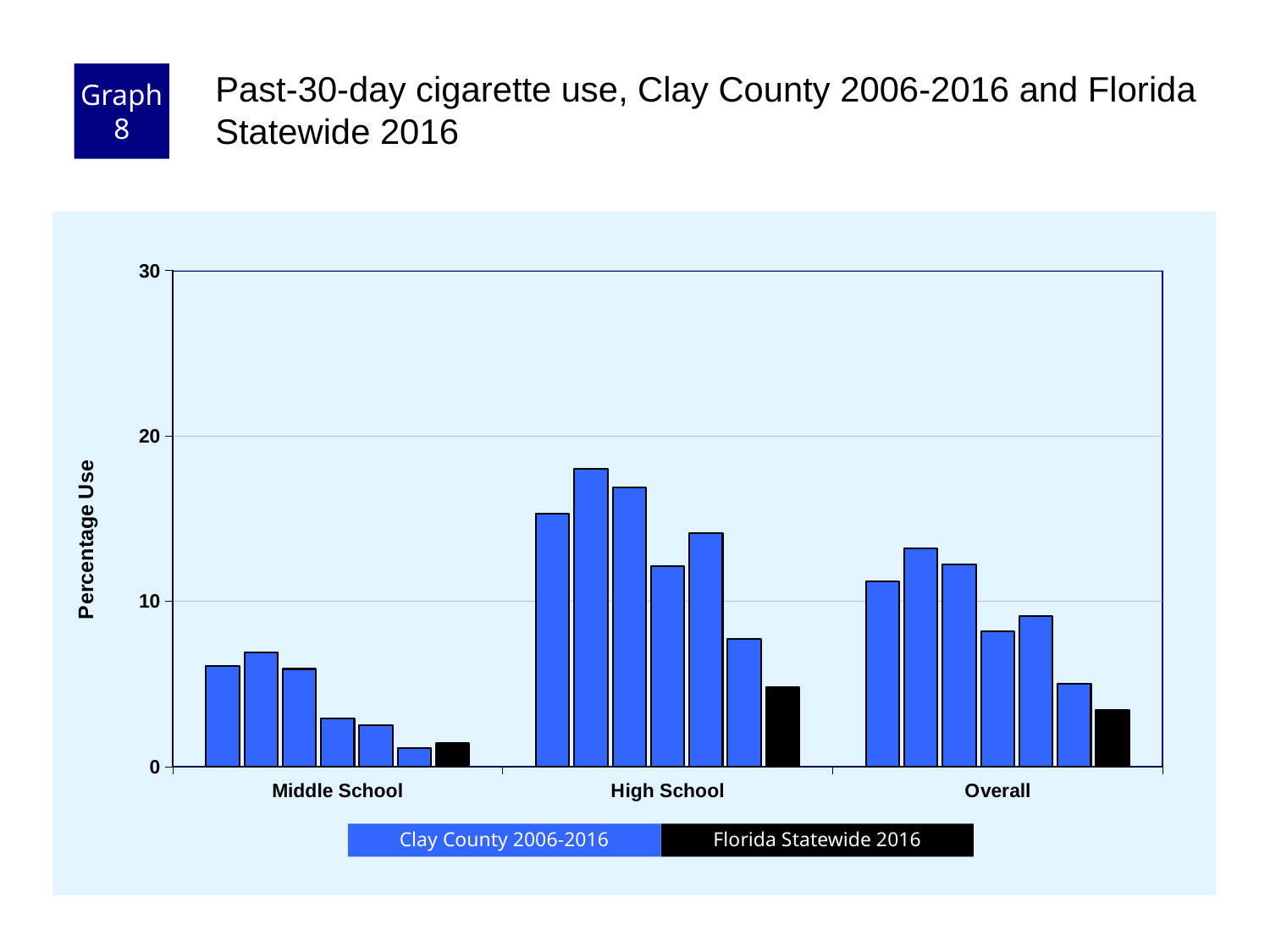
What colour are the Florida Statewide 2016 bars? black Which is larger, the Florida Statewide 2016 bar for High School or the Florida Statewide 2016 bar for Middle School? High School What is the label on the y axis? Percentage Use What kind of chart is shown on the slide? bar chart Which category has the lowest bars overall? Middle School Is the Florida Statewide 2016 value for High School greater or less than 10? less How many series does the legend list? 2 Within the Middle School group, do the Clay County 2006-2016 bars generally rise or fall from left to right? fall Is the tallest Clay County 2006-2016 bar for High School greater or less than 20? less How many categories are shown on the x axis? 3 Which category has the tallest bar in the chart? High School Is the tallest Clay County 2006-2016 bar for Overall greater or less than 10? greater